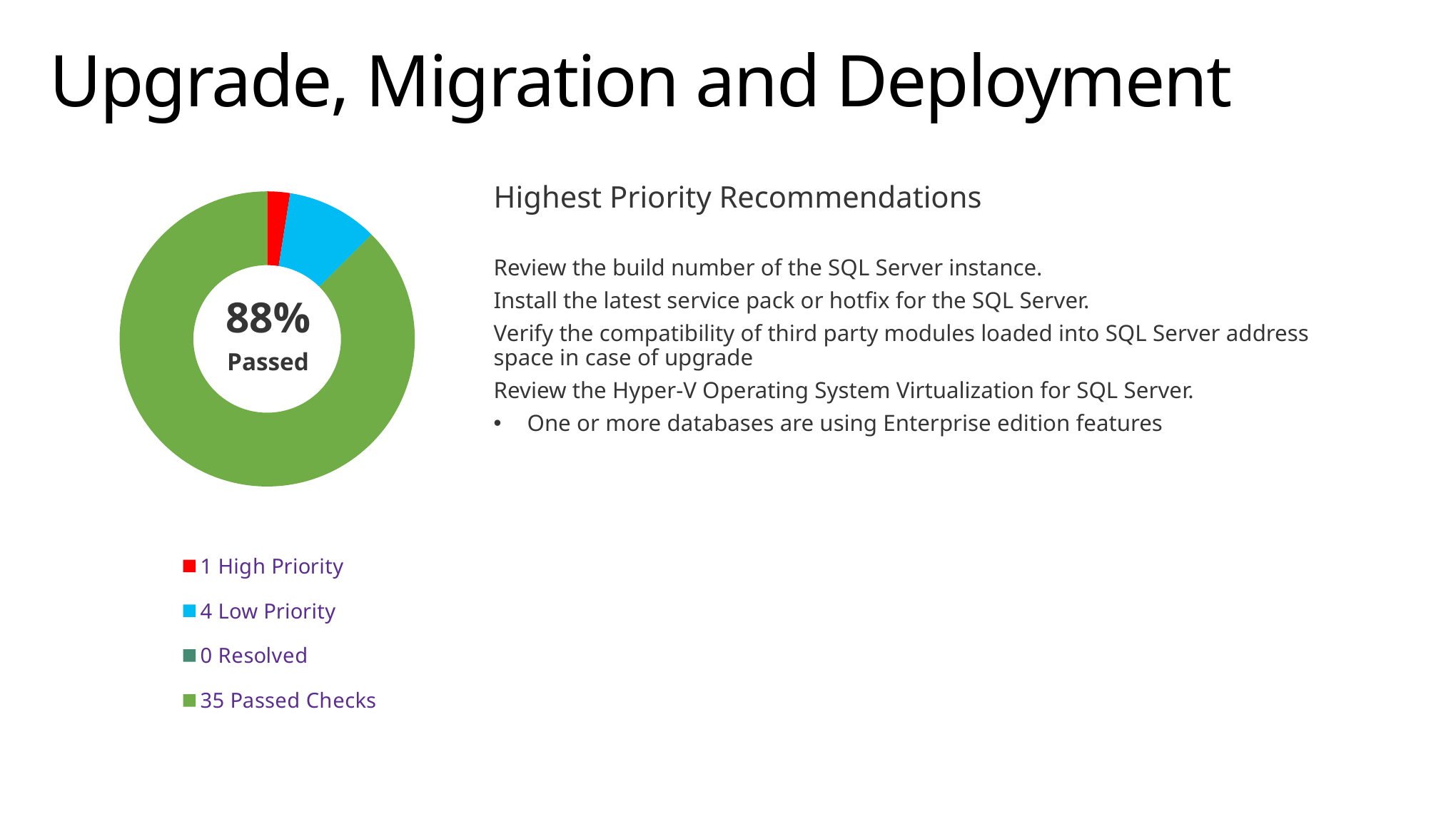
Which category has the largest value in the chart? Passed Checks How many Low Priority items does the legend show? 4 Which category has the smallest value in the chart? Resolved Which is larger, the number of Low Priority items or the number of High Priority items? Low Priority What percentage is printed in the centre of the doughnut chart? 88% How many Passed Checks does the legend show? 35 How many High Priority items does the legend show? 1 What is the difference between the number of Passed Checks and the number of Low Priority items? 31 What colour represents Passed Checks in the chart? Green How many Resolved items does the legend show? 0 What kind of chart is shown on the slide? Doughnut chart How many categories does the legend list? 4